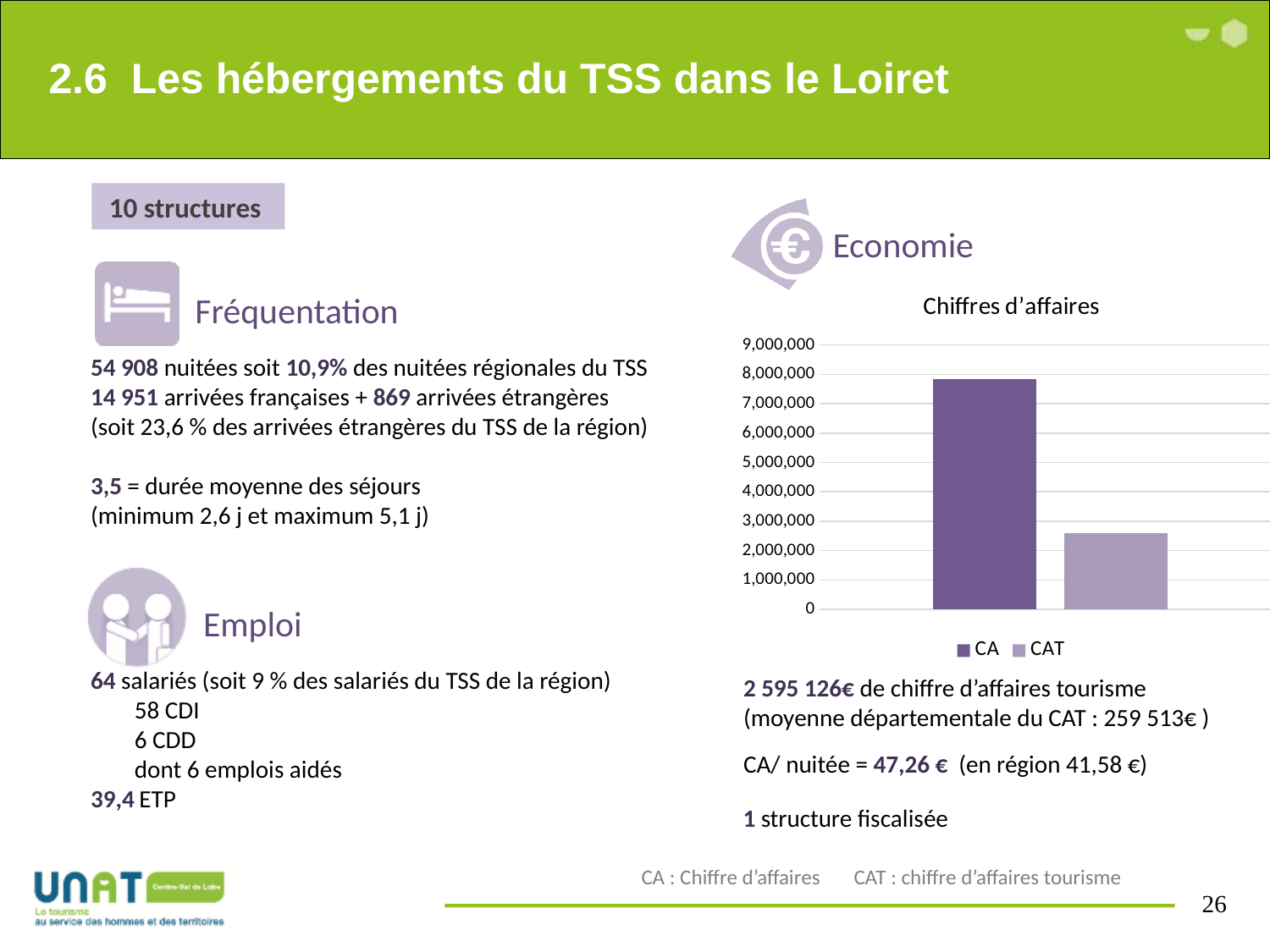
Is the value for CAT in the "Chiffres d'affaires" chart greater or less than 2,000,000? greater Which series has the shorter bar in the "Chiffres d'affaires" chart? CAT Which series has the taller bar in the "Chiffres d'affaires" chart? CA Is the value for CAT in the "Chiffres d'affaires" chart greater or less than 3,000,000? less In the "Chiffres d'affaires" chart, is the value for CA larger or smaller than the value for CAT? larger Is the value for CA in the "Chiffres d'affaires" chart greater or less than 7,000,000? greater What are the two legend entries of the "Chiffres d'affaires" chart? CA and CAT How many bars are plotted in the "Chiffres d'affaires" chart? 2 What kind of chart is shown under the title "Chiffres d'affaires"? bar chart How many series does the legend of the "Chiffres d'affaires" chart list? 2 What is the highest value shown on the vertical axis of the "Chiffres d'affaires" chart? 9,000,000